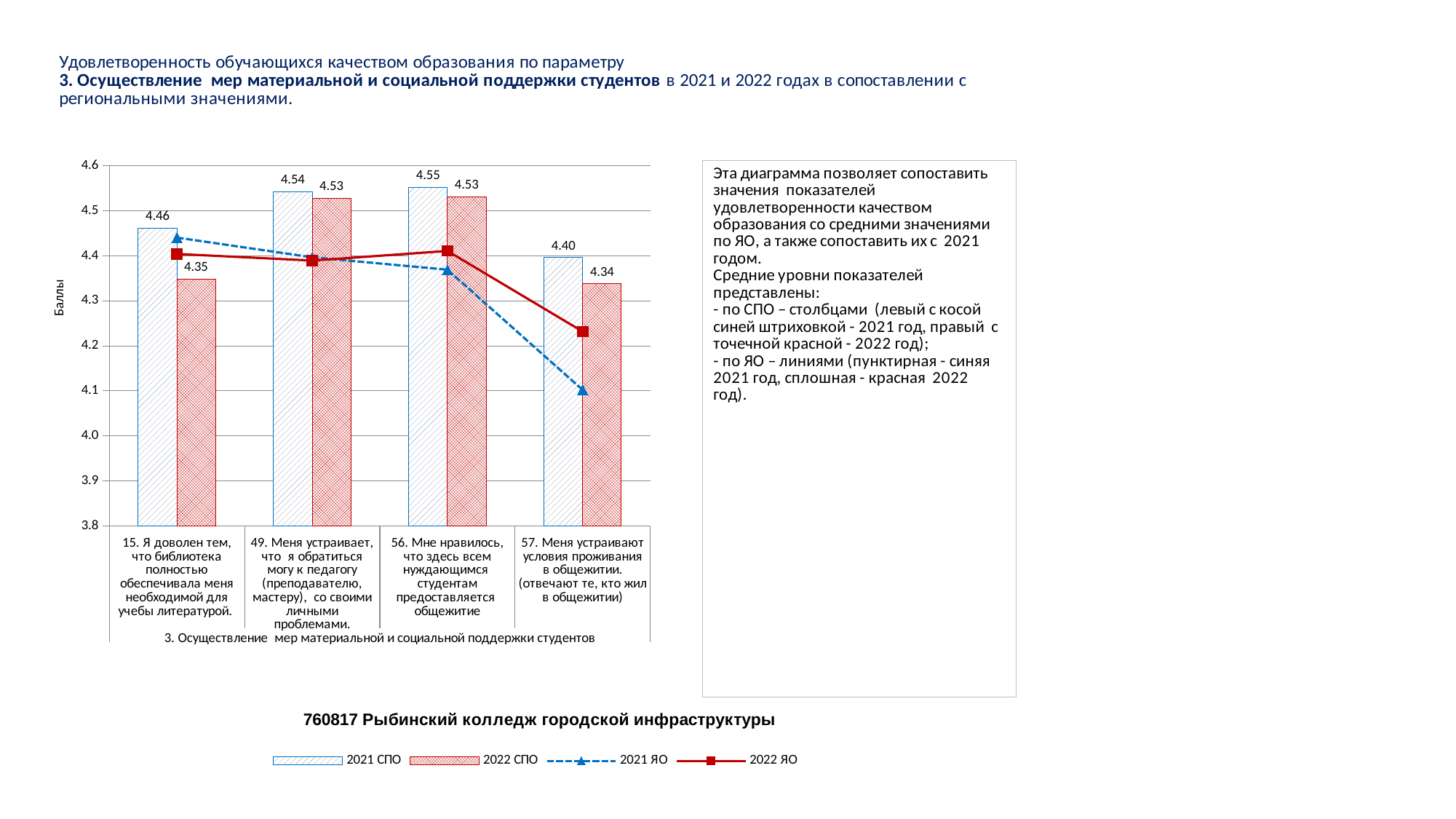
Which category has the lowest 2022 СПО value? 57. Меня устраивают условия проживания в общежитии Which is larger for category 57: the 2021 СПО value or the 2022 СПО value? 2021 СПО Is the 2022 ЯО value for category 56 greater or less than 4.3? greater What is the label of the vertical axis? Баллы How many categories are shown on the x axis? 4 Is the 2021 ЯО value for category 57 greater or less than 4.2? less Which category has the highest 2021 СПО value? 56. Мне нравилось, что здесь всем нуждающимся студентам предоставляется общежитие What is the 2022 СПО value for category 57 (Меня устраивают условия проживания в общежитии)? 4.34 What is the 2021 СПО value for category 15 (Я доволен тем, что библиотека полностью обеспечивала меня необходимой для учебы литературой)? 4.46 What is the 2022 СПО value for category 49 (Меня устраивает, что я обратиться могу к педагогу)? 4.53 What is the difference between the 2021 СПО and 2022 СПО values for category 15? 0.11 How many series does the legend list? 4